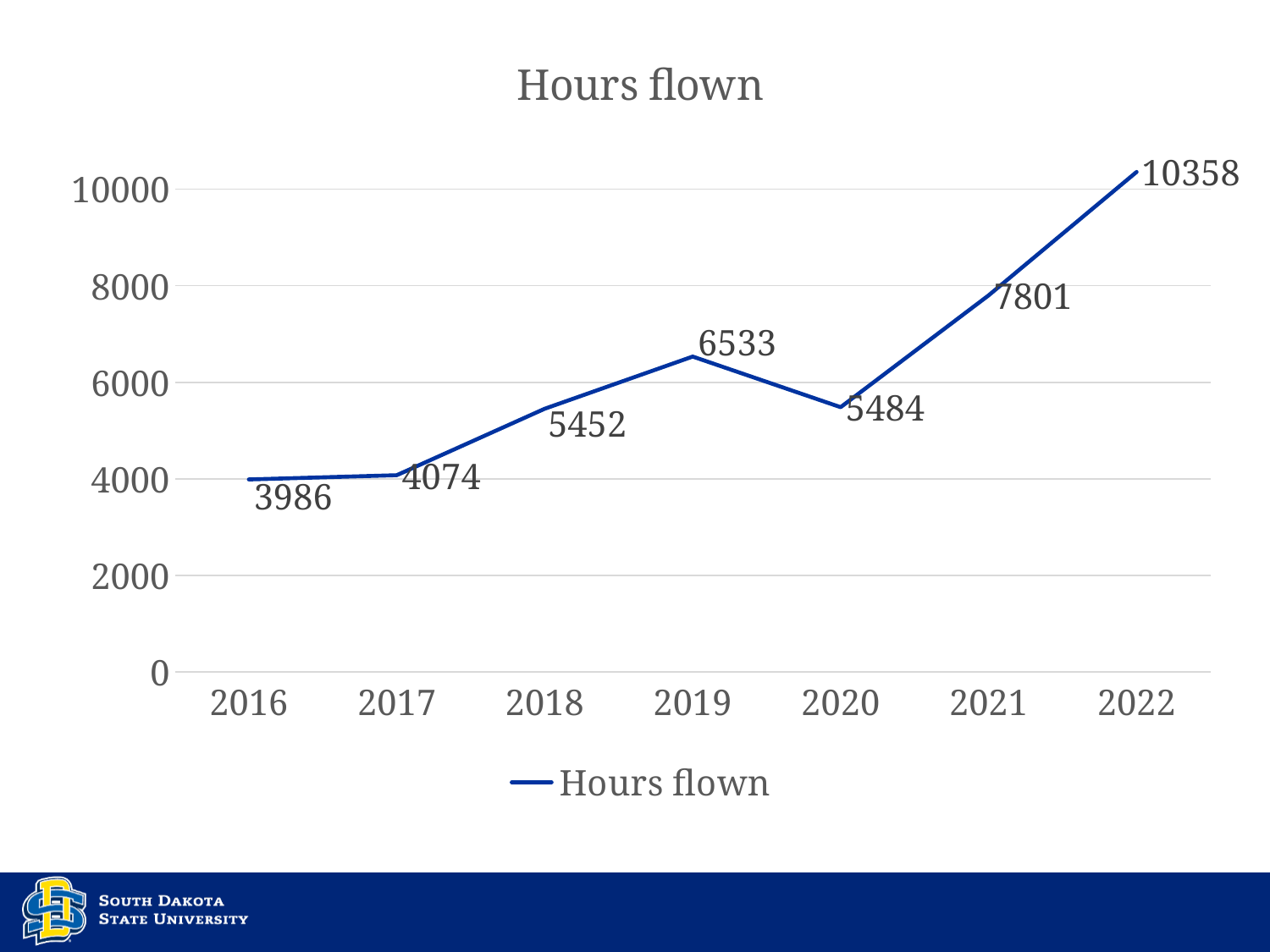
What kind of chart is shown on the slide? line chart What is the value for hours flown in 2021? 7801 Which year has the highest hours flown? 2022 What is the value for hours flown in 2016? 3986 Which year has more hours flown, 2018 or 2020? 2020 Is the value for hours flown in 2022 greater or less than 10000? greater How many years are plotted on the chart? 7 What is the title of the chart? Hours flown What is the difference in hours flown between 2022 and 2021? 2557 What is the value for hours flown in 2019? 6533 Which year has the lowest hours flown? 2016 What is the difference in hours flown between 2019 and 2020? 1049